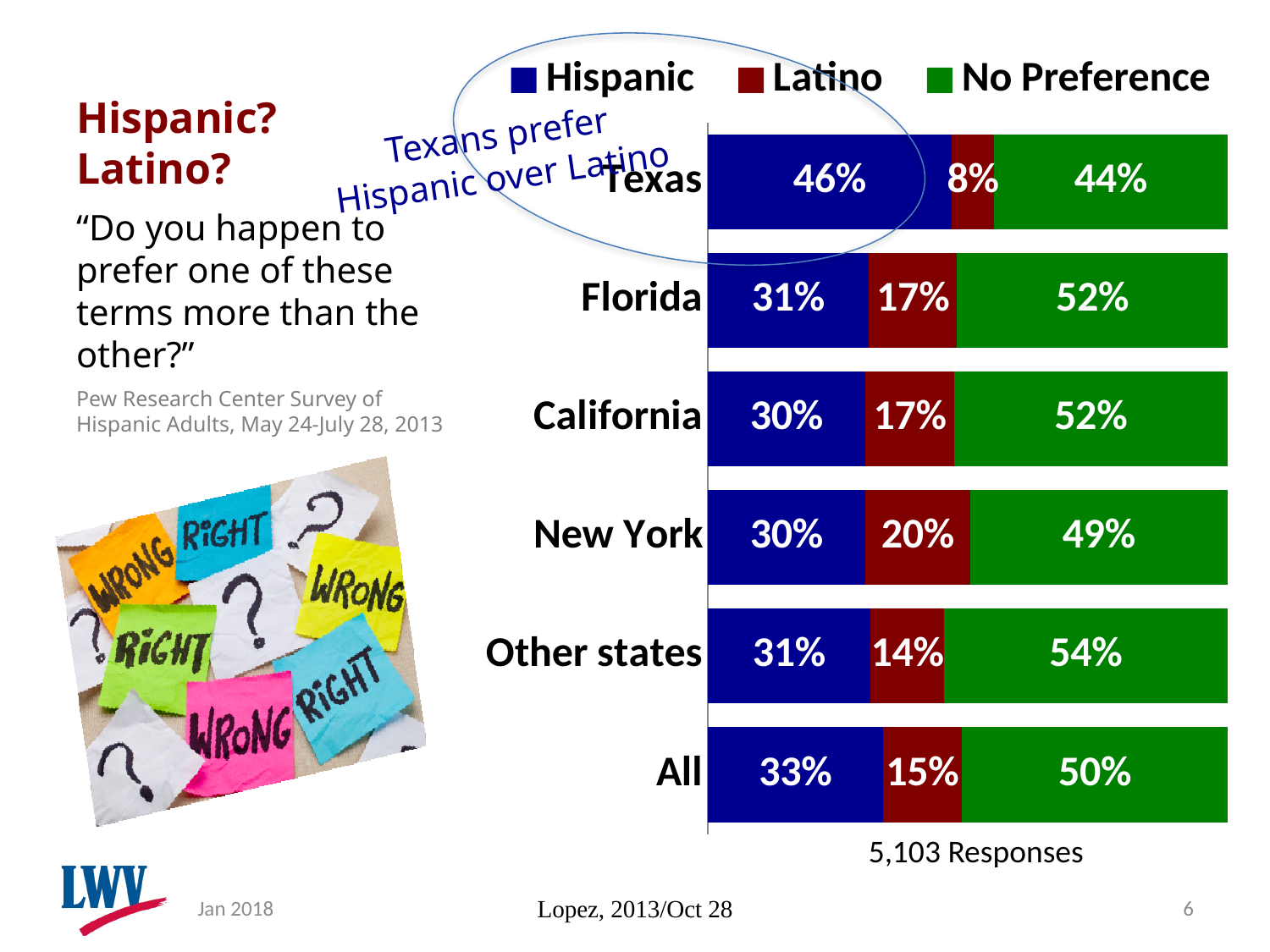
Which category has the lowest Latino value? Texas Which category has the highest Hispanic value? Texas How many categories are shown on the chart? 6 Which colour represents the No Preference series in the legend? Green How many series does the legend list? 3 What percentage of Texas respondents prefer the term Hispanic? 46% What is the No Preference value for Other states? 54% What percentage of New York respondents prefer Latino? 20% What is the difference between the Hispanic and Latino values for Texas? 38% What is the total of the stacked bar for All? 98% What kind of chart is shown on the slide? Stacked bar chart Which is larger for Florida: the Hispanic value or the No Preference value? No Preference